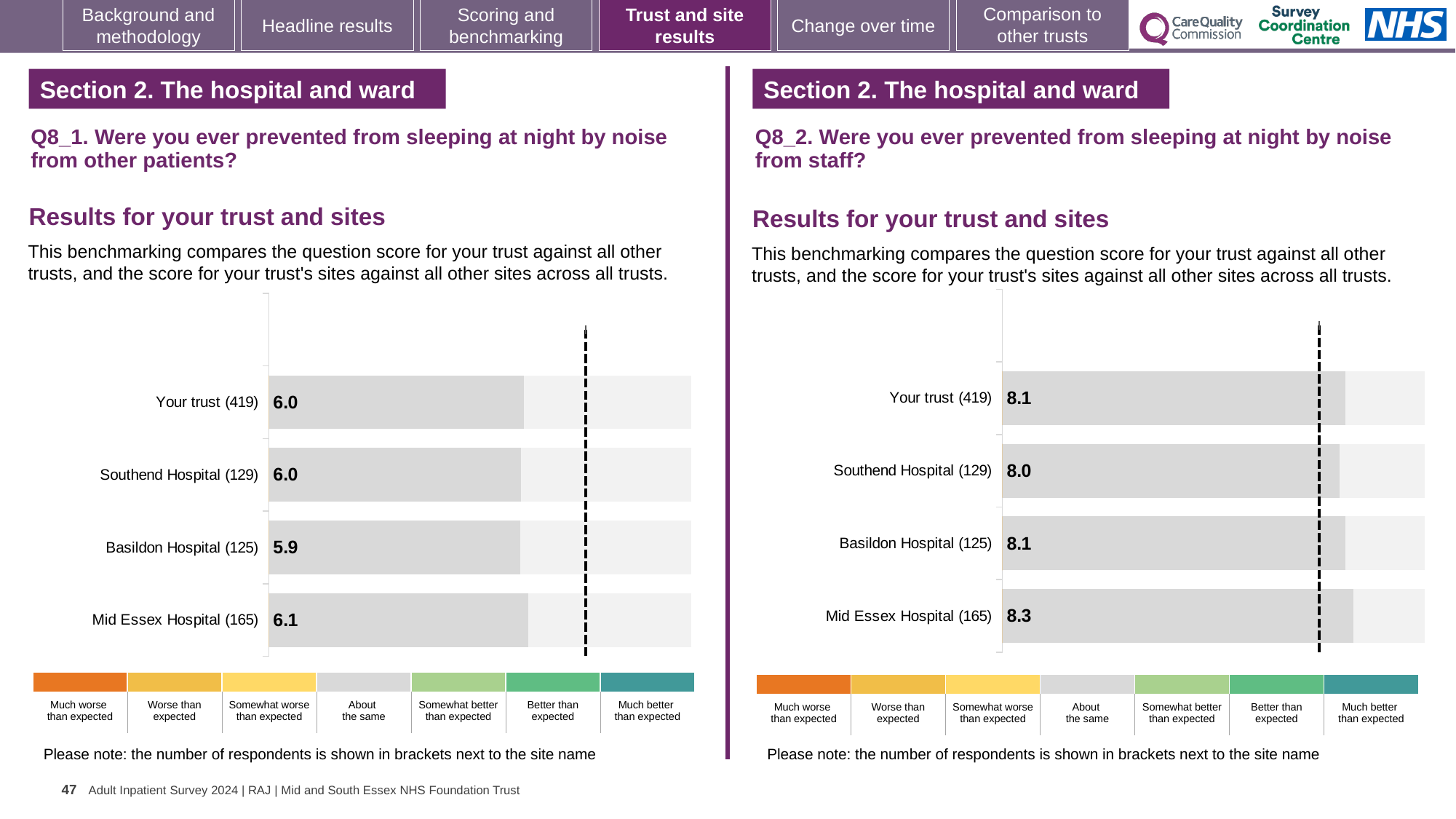
In the Q8_1 chart (noise from other patients), which site has the lowest score? Basildon Hospital (125) In the Q8_2 chart (noise from staff), what is the score for Southend Hospital (129)? 8.0 In the Q8_1 chart (noise from other patients), which site has the highest score? Mid Essex Hospital (165) How many bars are plotted in the Q8_1 chart (noise from other patients)? 4 In the Q8_1 chart (noise from other patients), what is the difference between the scores for Mid Essex Hospital and Basildon Hospital? 0.2 In the Q8_2 chart (noise from staff), which is larger: the score for Mid Essex Hospital or the score for Southend Hospital? Mid Essex Hospital In the Q8_1 chart (noise from other patients), what is the score for Your trust (419)? 6.0 In the Q8_2 chart (noise from staff), which site has the lowest score? Southend Hospital (129) What type of chart is used for the Q8_2 results (noise from staff)? Bar chart In the Q8_2 chart (noise from staff), what is the score for Mid Essex Hospital (165)? 8.3 In the Q8_1 chart (noise from other patients), what is the score for Basildon Hospital (125)? 5.9 In the Q8_2 chart (noise from staff), which site has the highest score? Mid Essex Hospital (165)